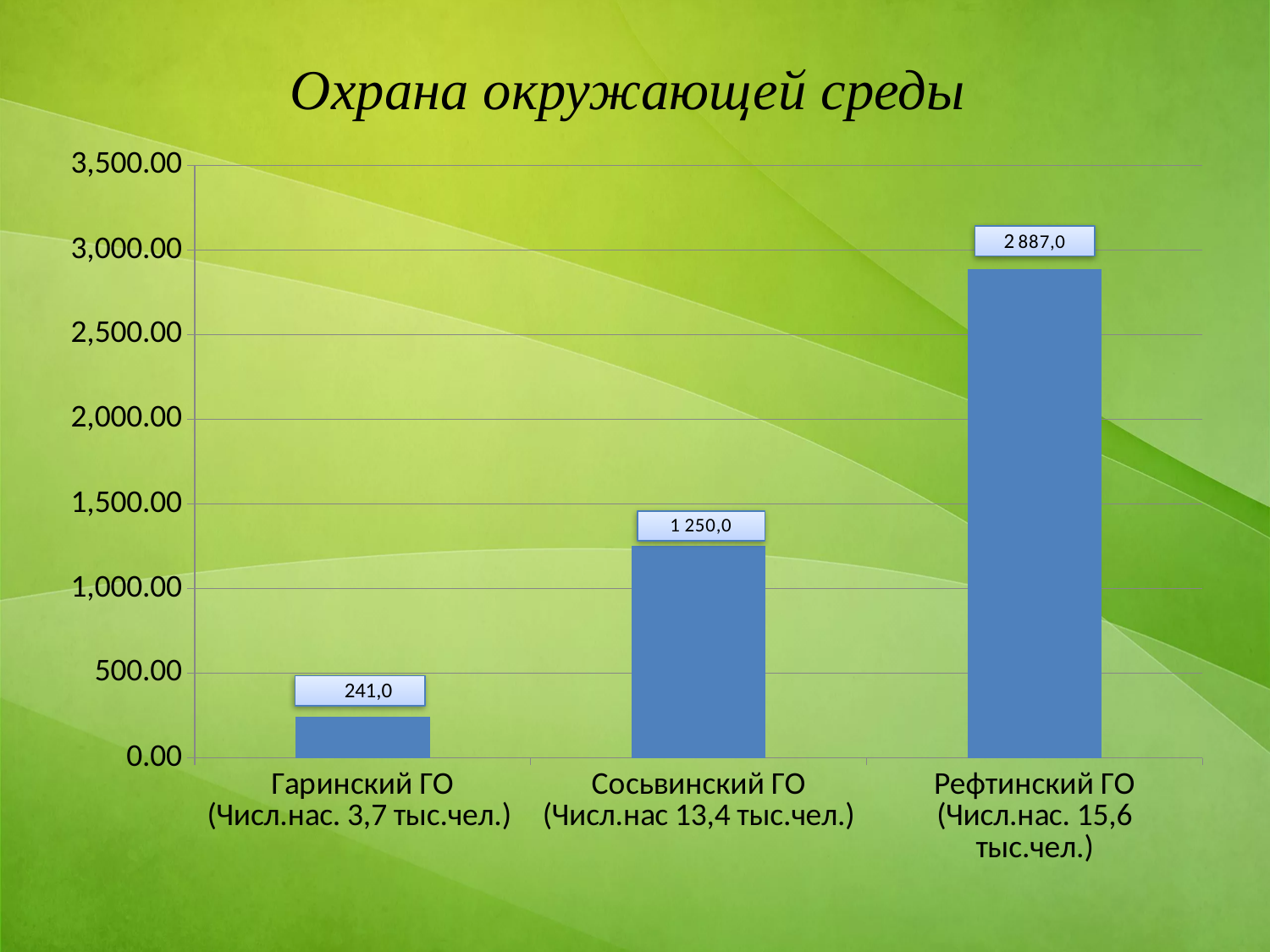
What kind of chart is shown on the slide? bar chart What is the value for Сосьвинский ГО? 1 250,0 What is the difference between the values for Рефтинский ГО and Сосьвинский ГО? 1 637,0 Which category has the lowest value? Гаринский ГО What is the difference between the values for Сосьвинский ГО and Гаринский ГО? 1 009,0 Is the value for Рефтинский ГО greater or less than 2,500.00? greater Which is larger, the value for Сосьвинский ГО or the value for Гаринский ГО? Сосьвинский ГО What is the value for Гаринский ГО? 241,0 Which category has the highest value? Рефтинский ГО What is the value for Рефтинский ГО? 2 887,0 How many categories are shown on the chart? 3 What is the title of the slide? Охрана окружающей среды